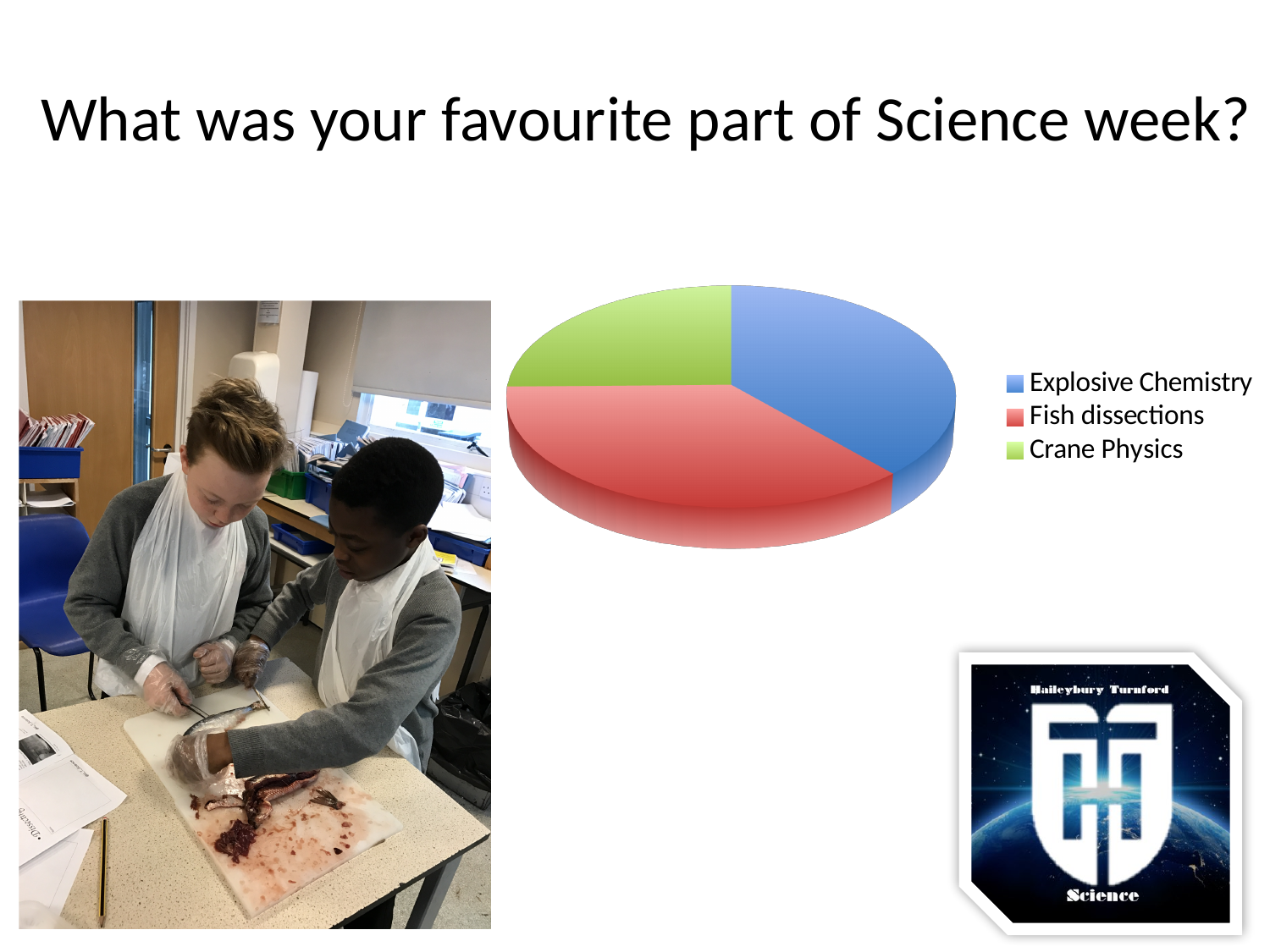
How many slices does the pie chart have? 3 Which slice is larger in the pie chart, Fish dissections or Crane Physics? Fish dissections What kind of chart is shown on the slide? pie chart Which category has the smallest slice in the pie chart? Crane Physics What colour is the Fish dissections slice in the pie chart? red How many entries does the legend of the pie chart list? 3 Which slice is larger in the pie chart, Crane Physics or Explosive Chemistry? Explosive Chemistry Which category is shown in green in the pie chart? Crane Physics